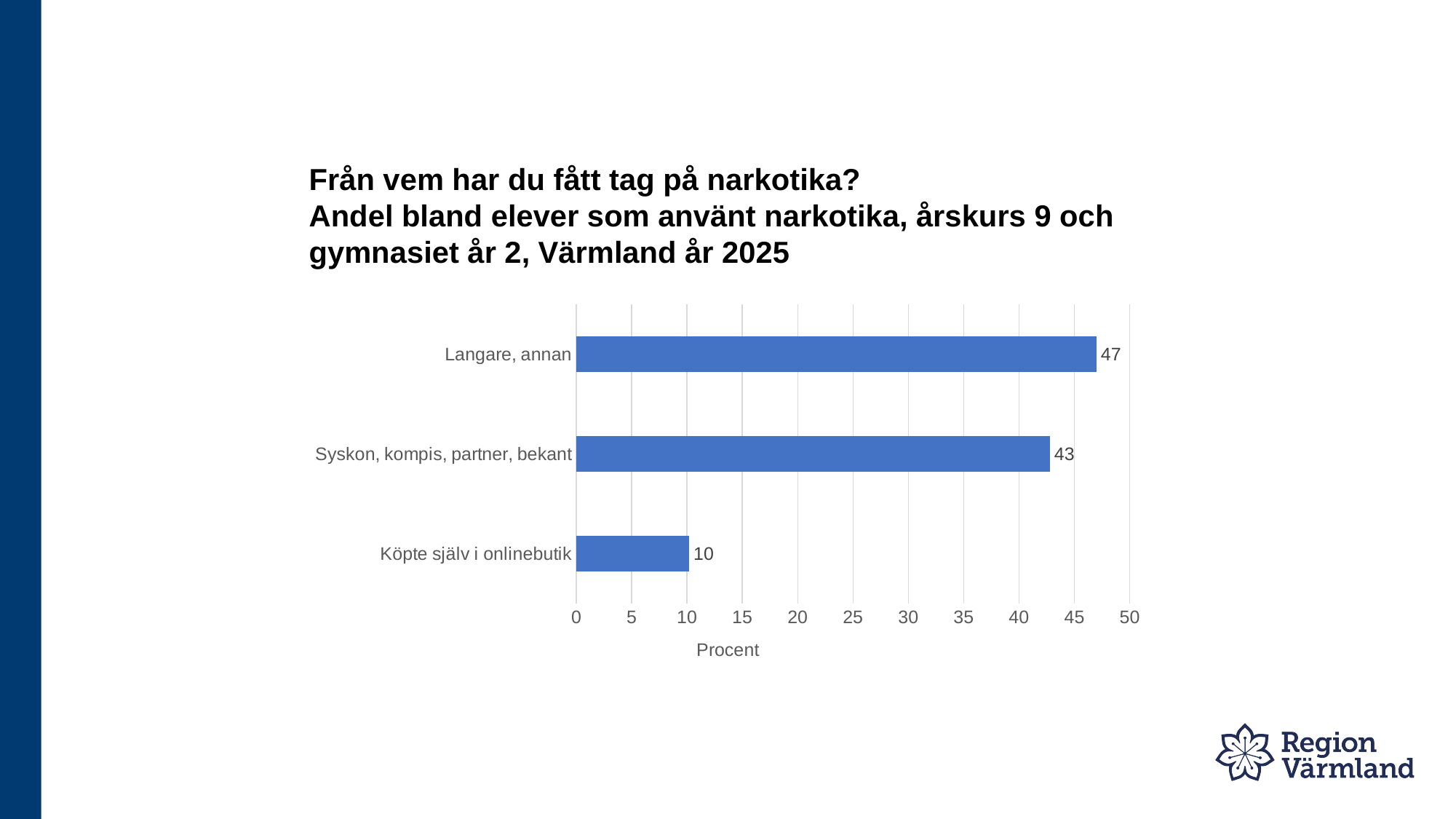
How many categories are shown in the chart? 3 What is the value for "Syskon, kompis, partner, bekant"? 43 What kind of chart is shown on the slide? Bar chart What is the label of the horizontal axis? Procent Which category has the lowest value? Köpte själv i onlinebutik Which is larger: the value for "Langare, annan" or for "Köpte själv i onlinebutik"? Langare, annan What is the difference between the values for "Langare, annan" and "Syskon, kompis, partner, bekant"? 4 What is the difference between the values for "Syskon, kompis, partner, bekant" and "Köpte själv i onlinebutik"? 33 Is the value for "Syskon, kompis, partner, bekant" greater or less than 40? greater Which category has the highest value? Langare, annan What is the value for "Köpte själv i onlinebutik"? 10 What is the value for "Langare, annan"? 47